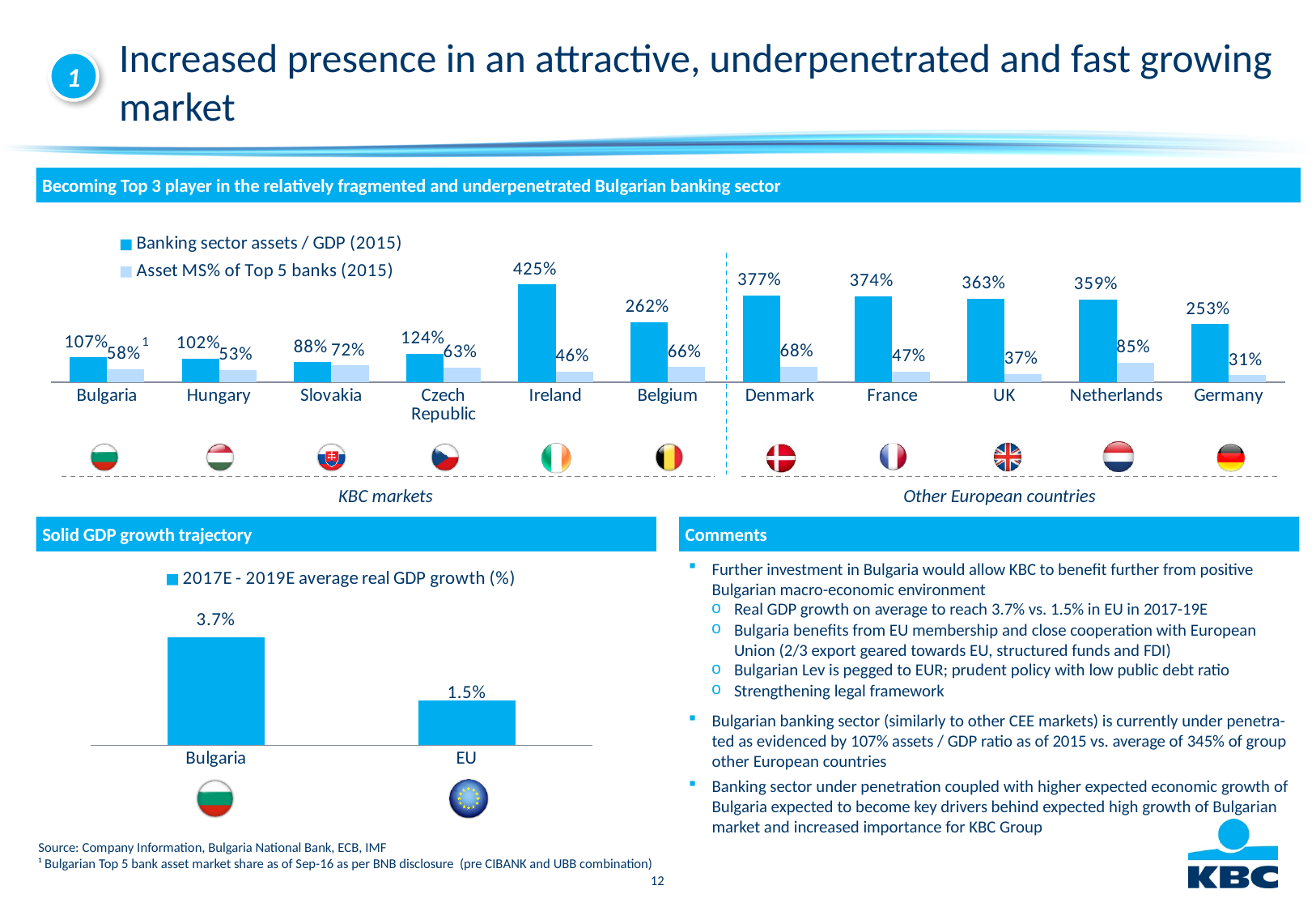
How many series does the legend of the top chart list? 2 In the top chart, what is the Asset MS% of Top 5 banks (2015) value for Bulgaria? 58% In the 'Solid GDP growth trajectory' chart, what is the 2017E - 2019E average real GDP growth for Bulgaria? 3.7% In the top chart, which is larger: the Asset MS% of Top 5 banks (2015) for Slovakia or for the Czech Republic? Slovakia In the top chart, which country has the highest Banking sector assets / GDP (2015)? Ireland In the top chart, what is the Banking sector assets / GDP (2015) value for Ireland? 425% What kind of chart is the 'Solid GDP growth trajectory' chart? Bar chart In the top chart, which country has the highest Asset MS% of Top 5 banks (2015)? Netherlands In the top chart, what is the difference between the Banking sector assets / GDP (2015) values for Denmark and Germany? 124% In the 'Solid GDP growth trajectory' chart, what is the difference between the values for Bulgaria and the EU? 2.2% How many countries are shown in the top chart? 11 In the top chart, which country has the lowest Banking sector assets / GDP (2015)? Slovakia